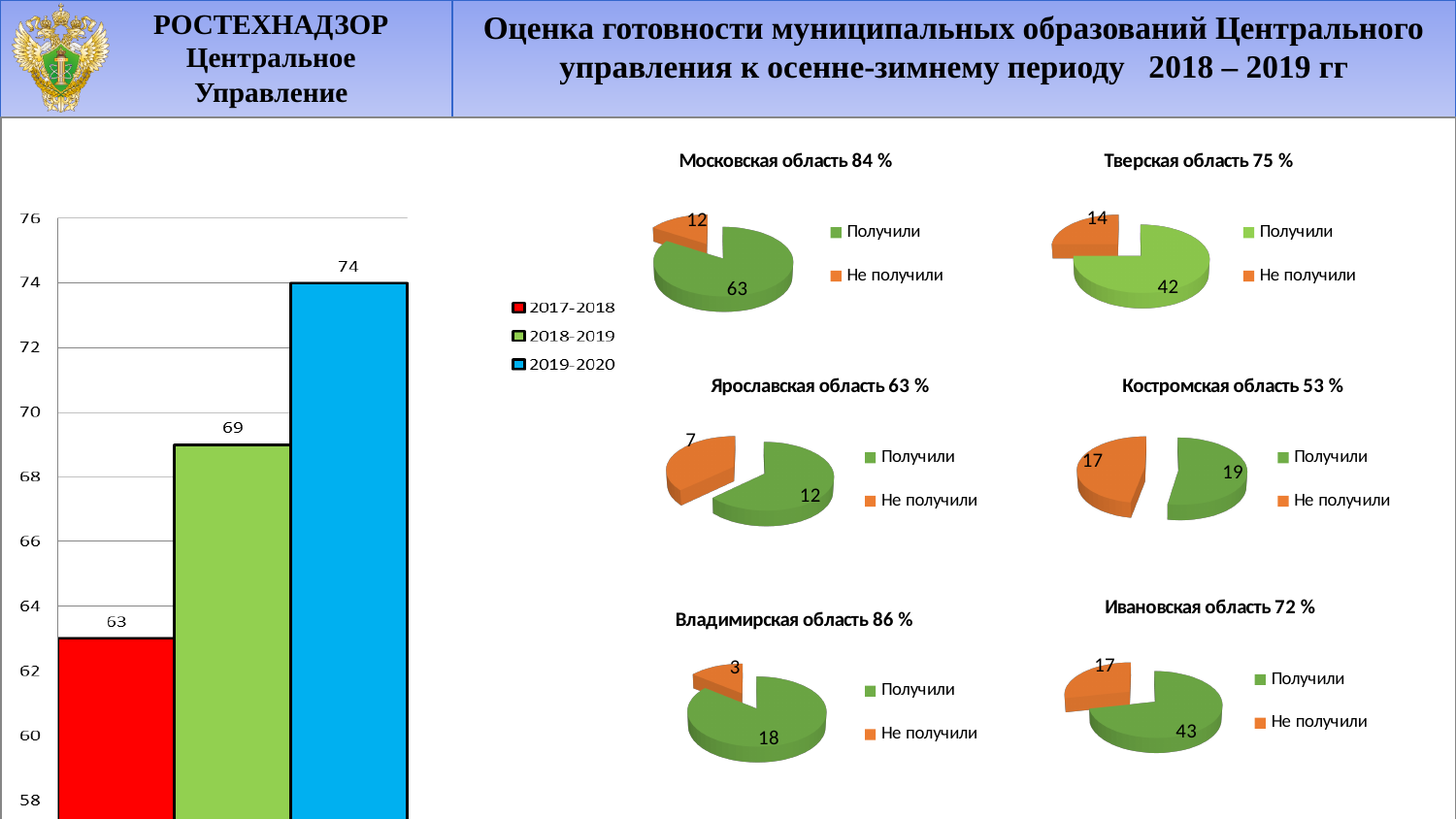
On the 'Тверская область 75 %' pie chart, what is the value for 'Не получили'? 14 On the bar chart on the left of the slide, do the values rise or fall from 2017-2018 to 2019-2020? rise On the 'Московская область 84 %' pie chart, what is the value for 'Получили'? 63 On the 'Костромская область 53 %' pie chart, which slice is larger, 'Получили' or 'Не получили'? Получили How many series does the legend of the bar chart on the left of the slide list? 3 On the bar chart on the left of the slide, what is the difference between the 2019-2020 value and the 2018-2019 value? 5 On the 'Владимирская область 86 %' pie chart, what is the total of 'Получили' and 'Не получили'? 21 What kind of chart is the 'Московская область 84 %' chart? pie chart On the bar chart on the left of the slide, which period has the highest value? 2019-2020 On the 'Ивановская область 72 %' pie chart, what is the difference between 'Получили' and 'Не получили'? 26 On the bar chart on the left of the slide, what is the value for 2017-2018? 63 On the bar chart on the left of the slide, what is the value for 2019-2020? 74